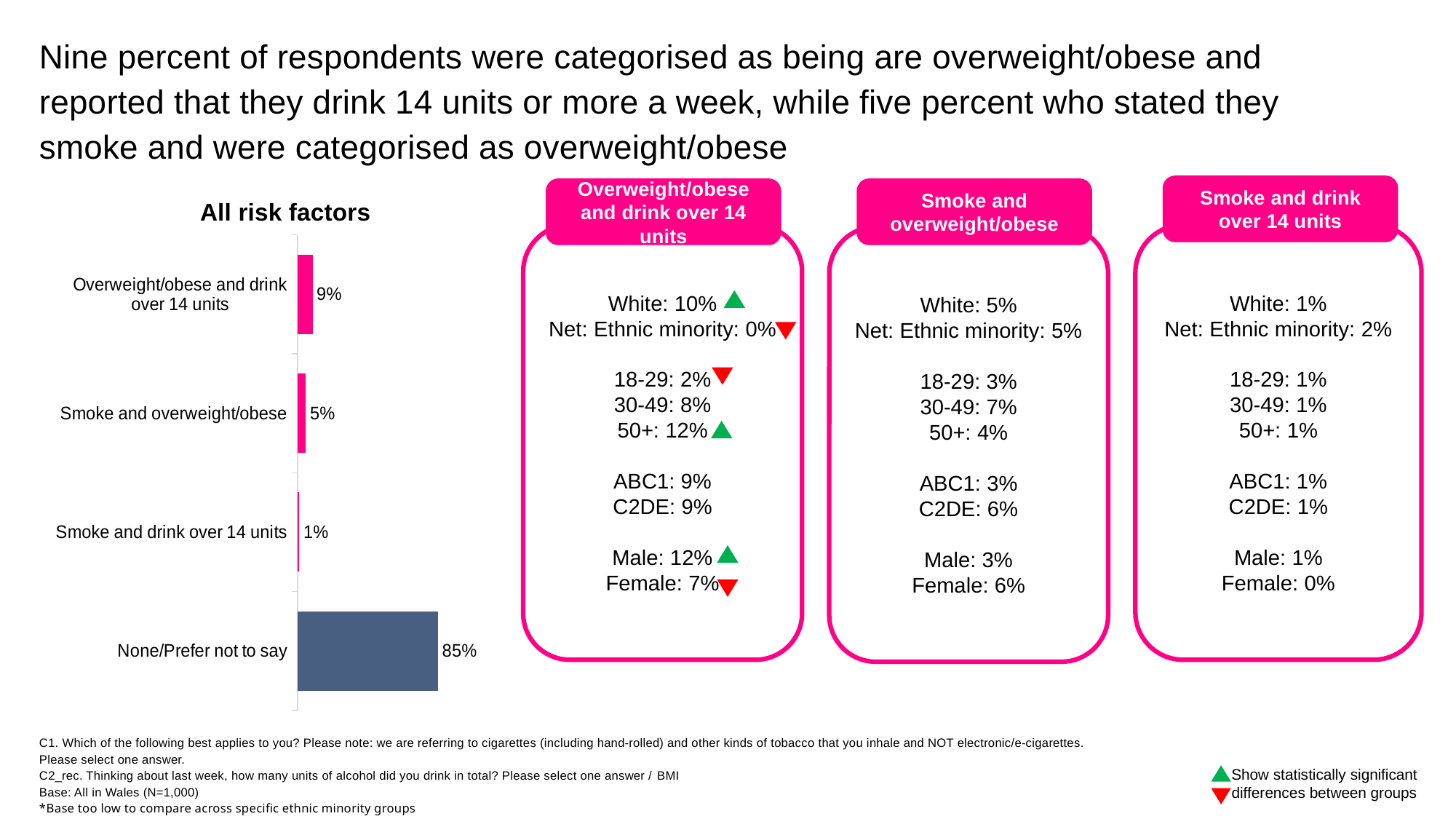
Which is larger in the 'All risk factors' chart: 'Smoke and overweight/obese' or 'Smoke and drink over 14 units'? Smoke and overweight/obese What is the value for 'Smoke and drink over 14 units' in the 'All risk factors' chart? 1% Which category has the lowest value in the 'All risk factors' chart? Smoke and drink over 14 units What is the difference between 'None/Prefer not to say' and 'Overweight/obese and drink over 14 units' in the 'All risk factors' chart? 76% What is the value for 'Smoke and overweight/obese' in the 'All risk factors' chart? 5% How many categories are shown in the 'All risk factors' chart? 4 What is the value for 'Overweight/obese and drink over 14 units' in the 'All risk factors' chart? 9% What is the title of the bar chart on the slide? All risk factors What is the value for 'None/Prefer not to say' in the 'All risk factors' chart? 85% Which category has the highest value in the 'All risk factors' chart? None/Prefer not to say What type of chart is the 'All risk factors' chart? Bar chart What is the difference between 'Overweight/obese and drink over 14 units' and 'Smoke and overweight/obese' in the 'All risk factors' chart? 4%